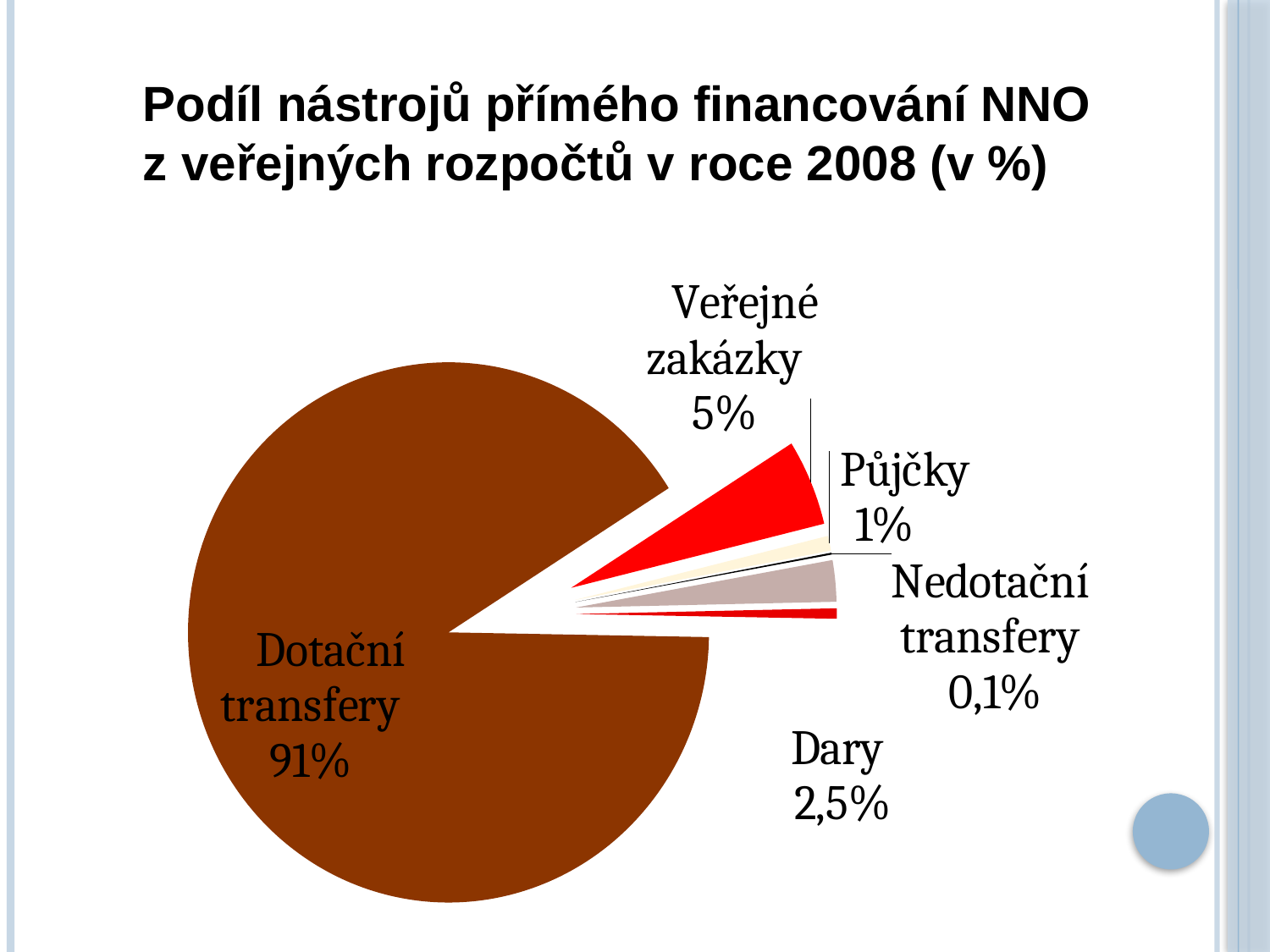
What is the value shown for Veřejné zakázky? 5% What is the difference between the shares of Dotační transfery and Veřejné zakázky? 86% What is the value shown for Půjčky? 1% What kind of chart is shown on the slide? Pie chart Which category has the largest slice of the pie? Dotační transfery What share of the pie does Dotační transfery hold? 91% What is the value shown for Nedotační transfery? 0,1% Which category has the smallest slice of the pie? Nedotační transfery What is the value shown for Dary? 2,5% Which is larger, the share for Dary or the share for Půjčky? Dary What is the difference between the shares of Veřejné zakázky and Dary? 2,5%